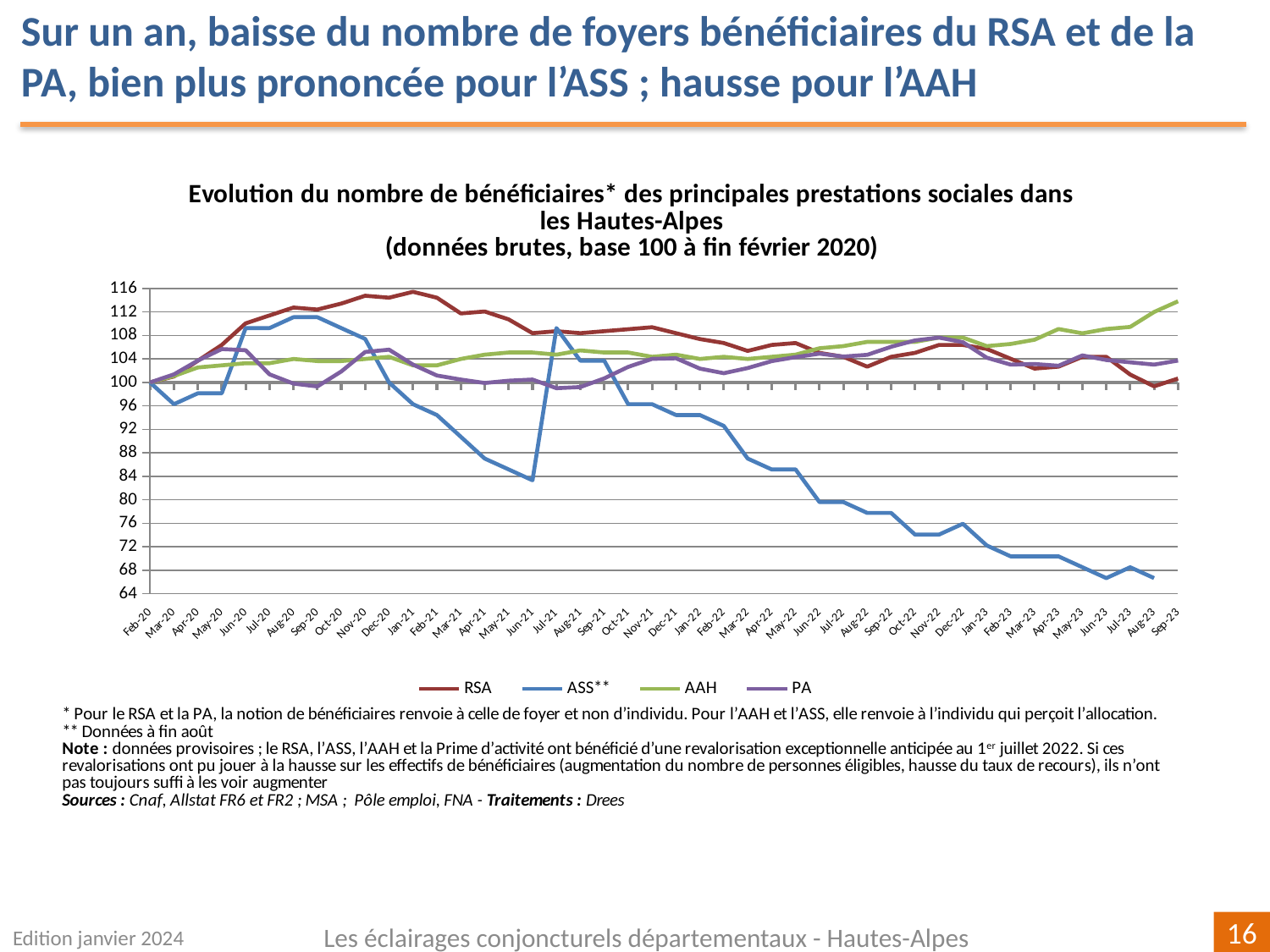
Which series is the lowest at Sep-23? RSA At Feb-22, which is higher, RSA or ASS**? RSA What kind of chart is shown on the slide? line chart Which series is the highest at Jan-21? RSA Which series is the highest at Sep-23? AAH Is the value for AAH at Sep-23 greater or less than 112? greater What is the value of every series at Feb-20, the base month? 100 Which series is drawn in blue in the legend? ASS** Is the value for RSA at Jan-21 greater or less than 112? greater Does the ASS** series rise or fall between Jul-21 and Sep-23? fall How many series does the legend list? 4